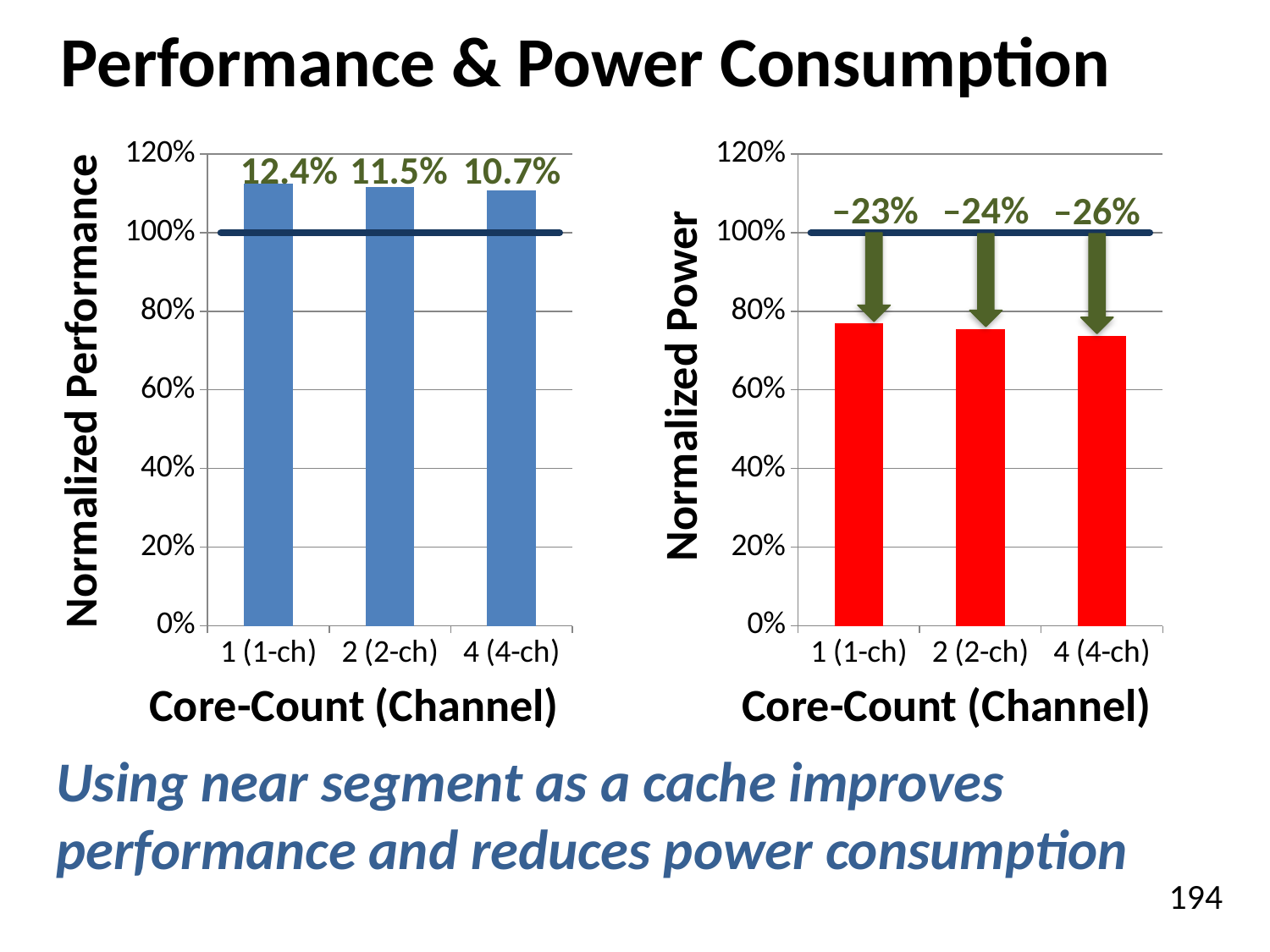
On the Normalized Performance chart, is the value for 2 (2-ch) greater or less than 100%? greater On the Normalized Power chart, is the value for 1 (1-ch) greater or less than 80%? less On the Normalized Power chart, what percentage change is printed above the 4 (4-ch) bar? –26% On the Normalized Performance chart, what percentage improvement is printed above the 4 (4-ch) bar? 10.7% On the Normalized Power chart, which core-count category has the lowest normalized power? 4 (4-ch) On the Normalized Power chart, is the bar for 2 (2-ch) greater or less than 60%? greater What is the x-axis title of the Normalized Power chart? Core-Count (Channel) On the Normalized Power chart, what percentage change is printed above the 1 (1-ch) bar? –23% How many core-count categories are shown on the x axis of the Normalized Performance chart? 3 On the Normalized Performance chart, what percentage improvement is printed above the 1 (1-ch) bar? 12.4% On the Normalized Performance chart, do the bar values rise or fall as core-count increases from 1 (1-ch) to 4 (4-ch)? fall What type of chart is the left chart titled Normalized Performance? bar chart